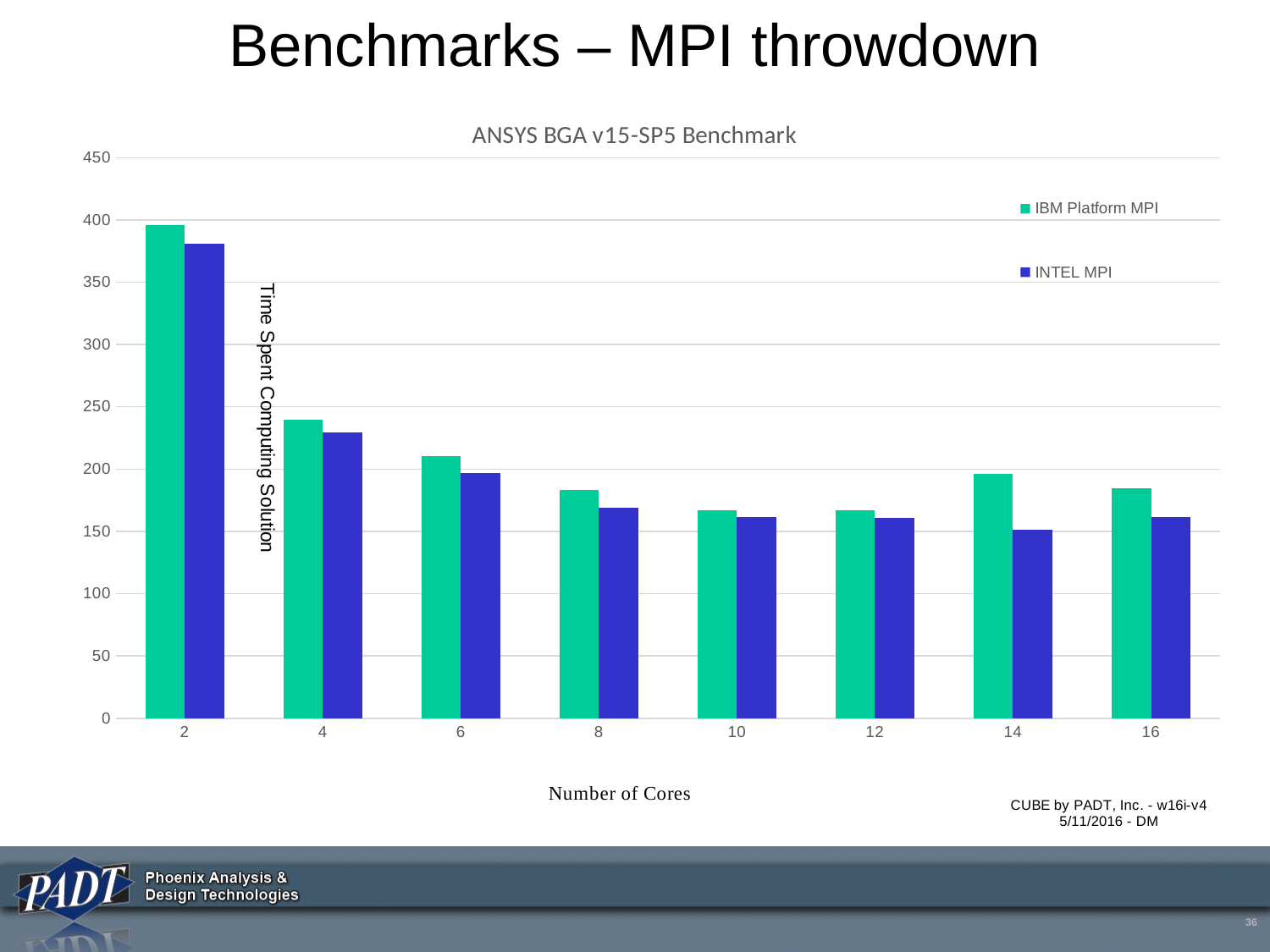
Which number of cores has the lowest INTEL MPI value? 14 Is the IBM Platform MPI value at 2 cores greater or less than 350? greater What is the label on the vertical axis? Time Spent Computing Solution Does the IBM Platform MPI value rise or fall as the number of cores increases from 2 to 8? fall At 14 cores, which series has the larger value, IBM Platform MPI or INTEL MPI? IBM Platform MPI How many series does the legend list? 2 What is the title of the chart? ANSYS BGA v15-SP5 Benchmark Which number of cores has the highest IBM Platform MPI value? 2 How many core-count categories are shown on the x axis? 8 Is the INTEL MPI value at 4 cores greater or less than 250? less Is the INTEL MPI value at 8 cores greater or less than 200? less What kind of chart is shown on the slide? bar chart